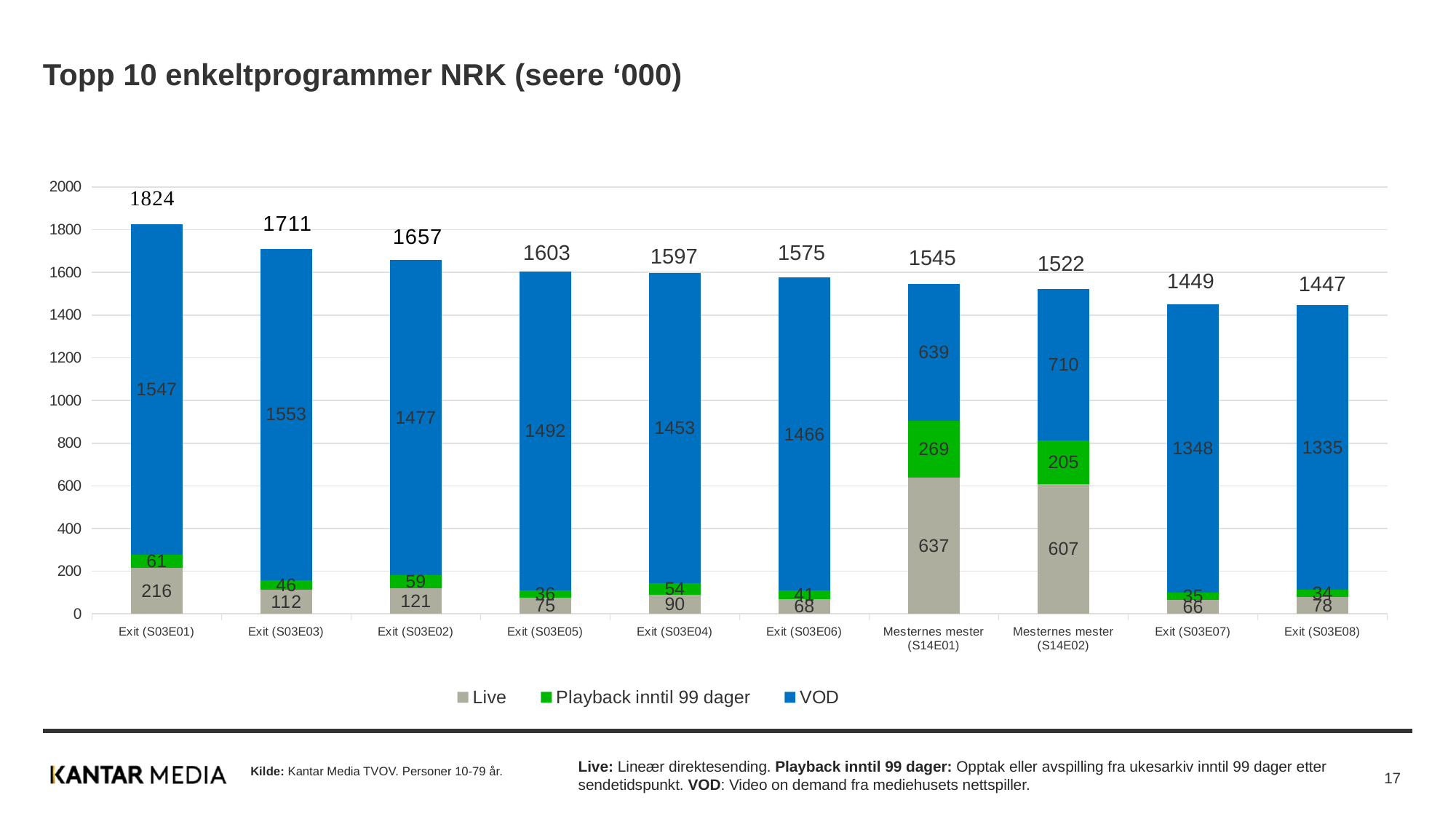
Which series is shown in blue in the legend? VOD What is the total for the Exit (S03E08) bar? 1447 How many programmes are shown on the x axis? 10 Which programme has the lowest total? Exit (S03E08) What is the VOD value for Exit (S03E01)? 1547 What is the Playback inntil 99 dager value for Mesternes mester (S14E02)? 205 What is the difference between the totals for Exit (S03E01) and Exit (S03E03)? 113 What is the Live value for Mesternes mester (S14E01)? 637 Which has the larger Live value, Mesternes mester (S14E01) or Exit (S03E02)? Mesternes mester (S14E01) How many series does the legend list? 3 Which programme has the highest total? Exit (S03E01) What type of chart is shown on the slide? Stacked bar chart